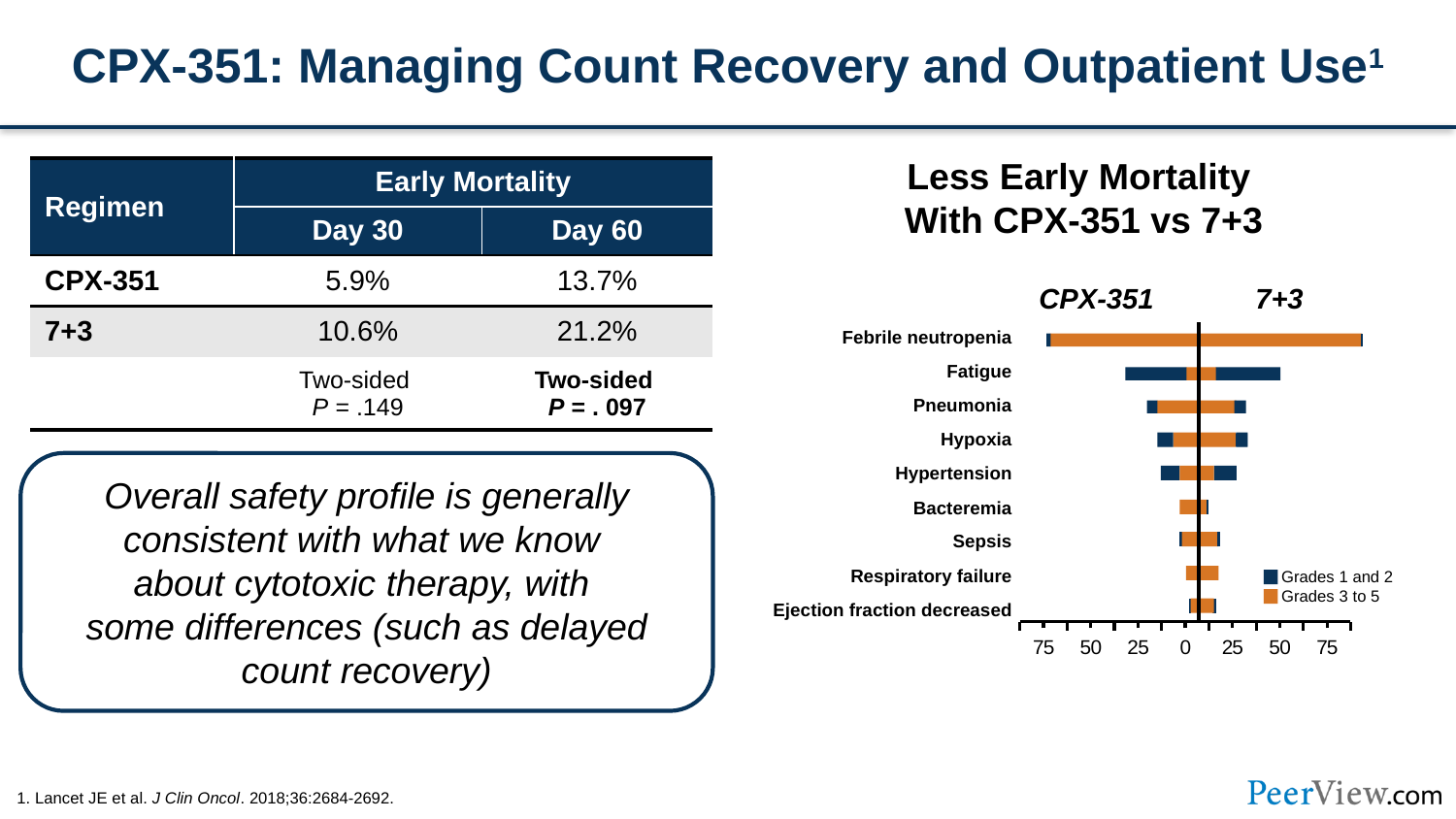
Which adverse event has the longest bars on the chart? Febrile neutropenia Which adverse event has the shortest bars on the chart? Ejection fraction decreased How many adverse event categories are listed on the bar chart? 9 Is the CPX-351 value for Sepsis greater or less than 25? less What kind of chart is shown on the right side of the slide? bar chart Which treatment arm is plotted on the left side of the bar chart? CPX-351 Is the 7+3 value for Bacteremia greater or less than 25? less Is the 7+3 value for Febrile neutropenia greater or less than 75? greater How many series does the legend of the bar chart list? 2 What are the two legend entries on the bar chart? Grades 1 and 2; Grades 3 to 5 For Febrile neutropenia, which arm has the longer bar, CPX-351 or 7+3? 7+3